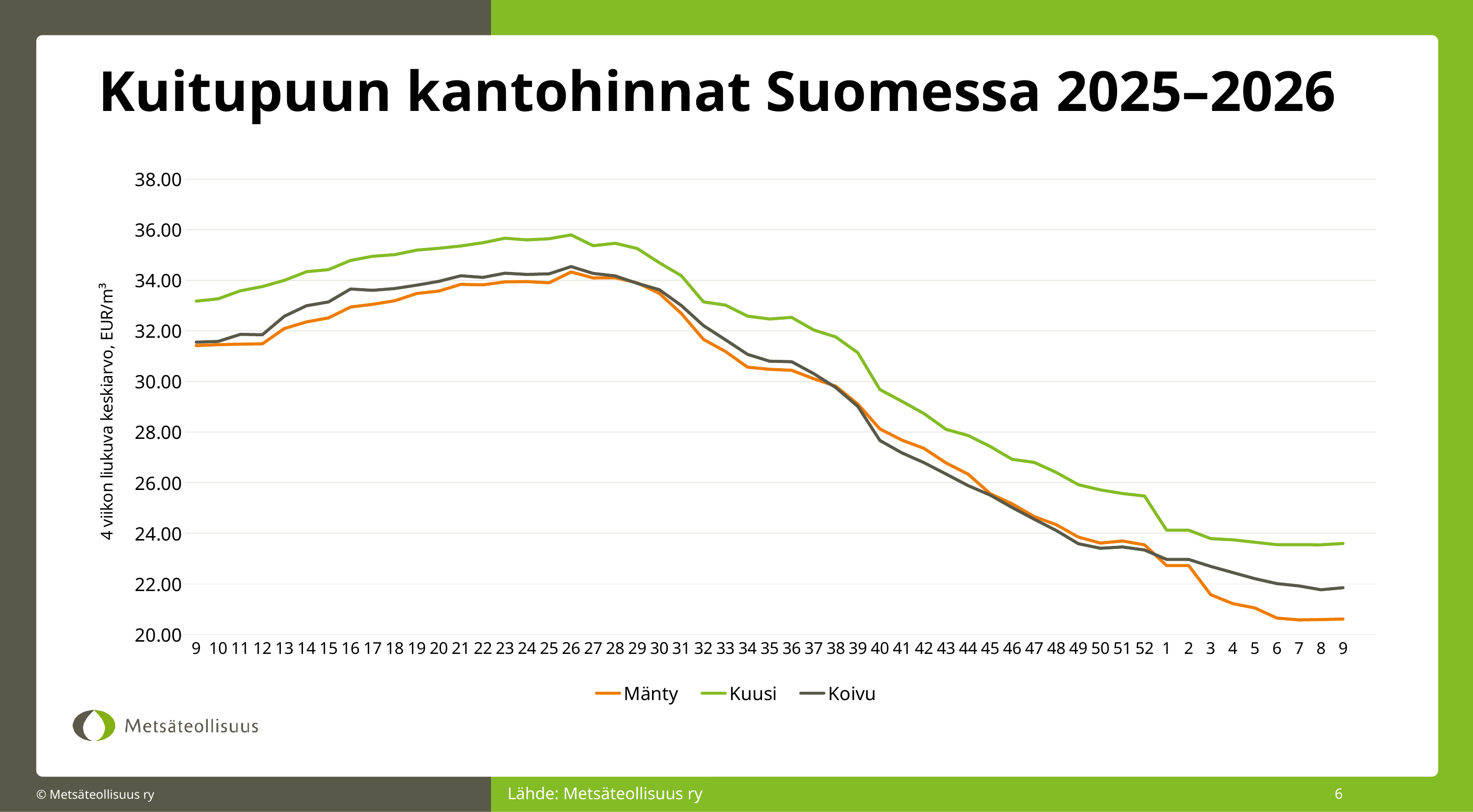
Is the value for Mänty at week 16 greater or less than 32.00? greater How many series does the legend list? 3 What is the title of the chart on the slide? Kuitupuun kantohinnat Suomessa 2025–2026 What are the three series named in the legend? Mänty, Kuusi, Koivu Is the value for Mänty at the final week 9 greater or less than 22.00? less At the final week 9, which is higher, Koivu or Mänty? Koivu Which series has the highest value at week 30? Kuusi Which series has the lowest value at week 5? Mänty Is the value for Kuusi at week 26 greater or less than 35.00? greater How many weekly points are plotted along the x axis? 53 Do the Mänty values rise or fall from week 26 to the final week 9? Fall What kind of chart is shown on the slide? Line chart